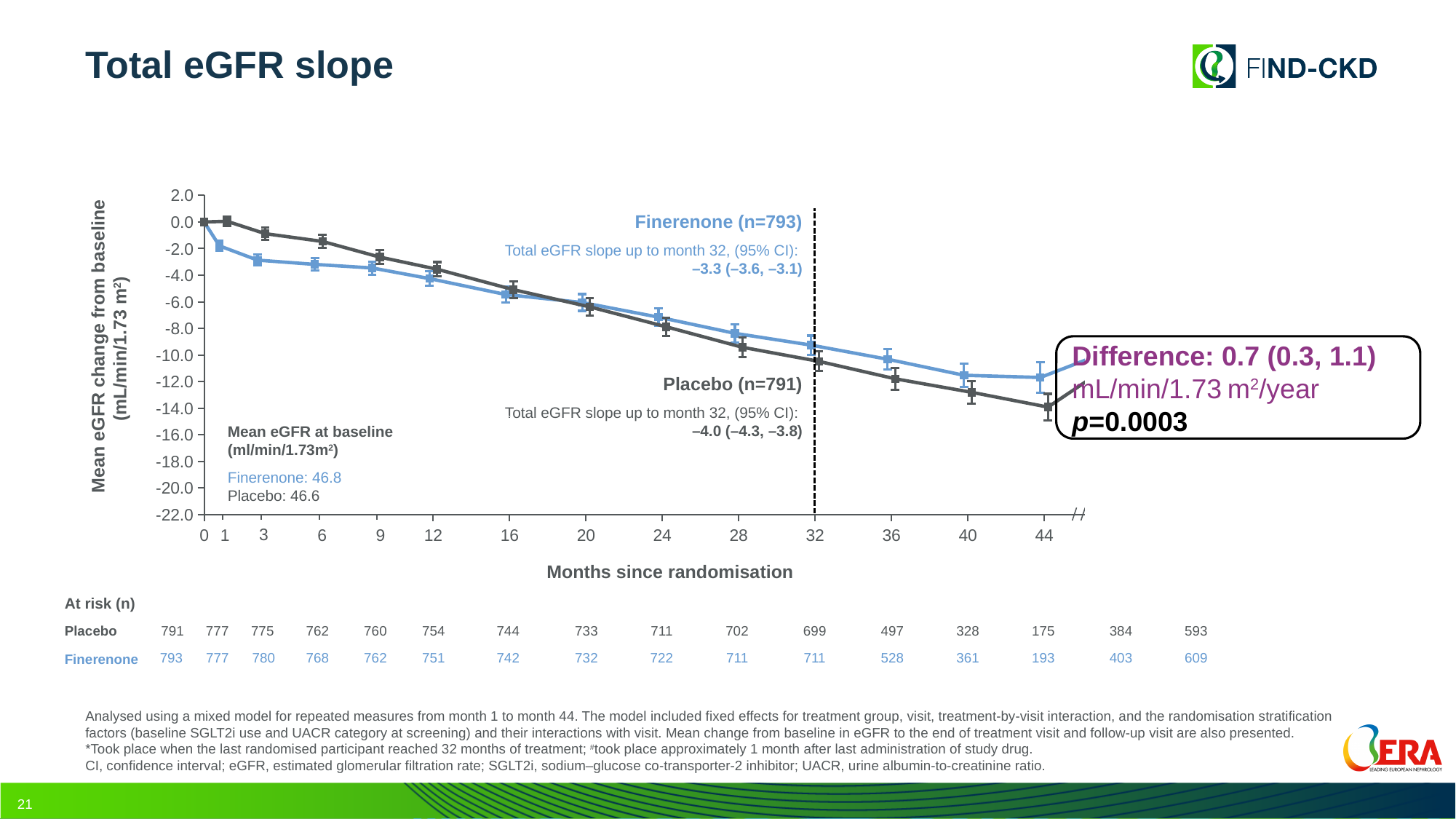
What is the difference in eGFR slope between the groups shown in the box on the chart? 0.7 (0.3, 1.1) mL/min/1.73 m²/year How many time points are labelled on the x axis of the chart? 14 What is the total eGFR slope up to month 32 for Placebo, as printed on the chart? –4.0 (–4.3, –3.8) How many treatment groups (series) are plotted in the chart? 2 Is the Finerenone value at month 1 greater or less than -4.0? greater What kind of chart is shown on the slide? line chart Is the Placebo value at month 44 greater or less than -12.0? less What is the number at risk for Placebo at month 32? 699 What is the total eGFR slope up to month 32 for Finerenone, as printed on the chart? –3.3 (–3.6, –3.1) At month 44, which group has the higher mean eGFR change from baseline, Finerenone or Placebo? Finerenone Do the mean eGFR change values for Placebo rise or fall over the months since randomisation? fall What is the mean eGFR at baseline for Finerenone? 46.8